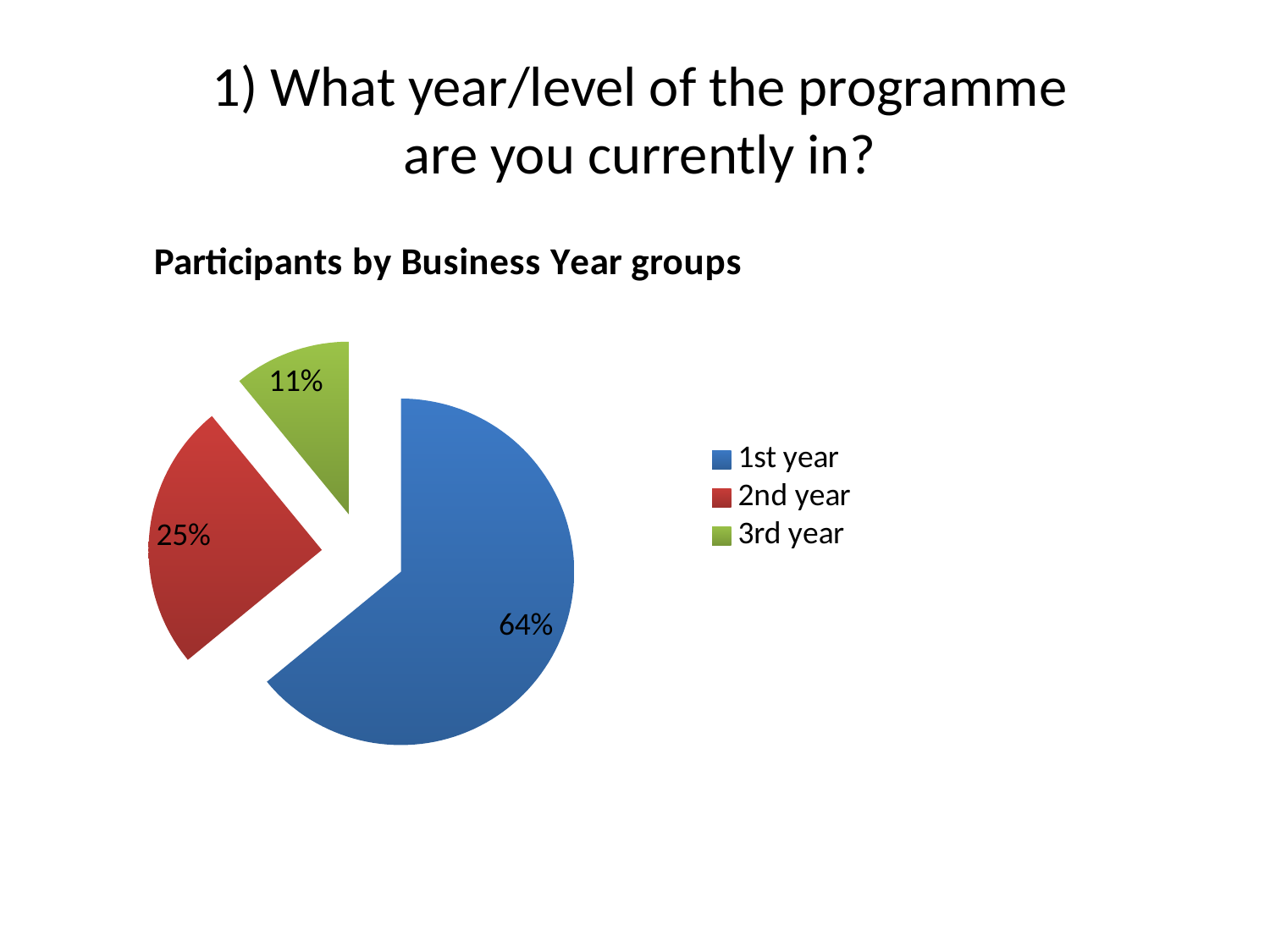
What share of participants are in 3rd year? 11% How many year groups are shown in the pie chart? 3 What colour is the slice for 3rd year? Green Which is larger, the share for 2nd year or the share for 3rd year? 2nd year What share of participants are in 2nd year? 25% What share of participants are in 1st year? 64% Which year group has the largest share of participants? 1st year What is the difference in percentage points between the 2nd year and 3rd year shares? 14 What kind of chart is shown on the slide? Pie chart What is the difference in percentage points between the 1st year and 2nd year shares? 39 What is the title of the chart? Participants by Business Year groups Which year group has the smallest share of participants? 3rd year